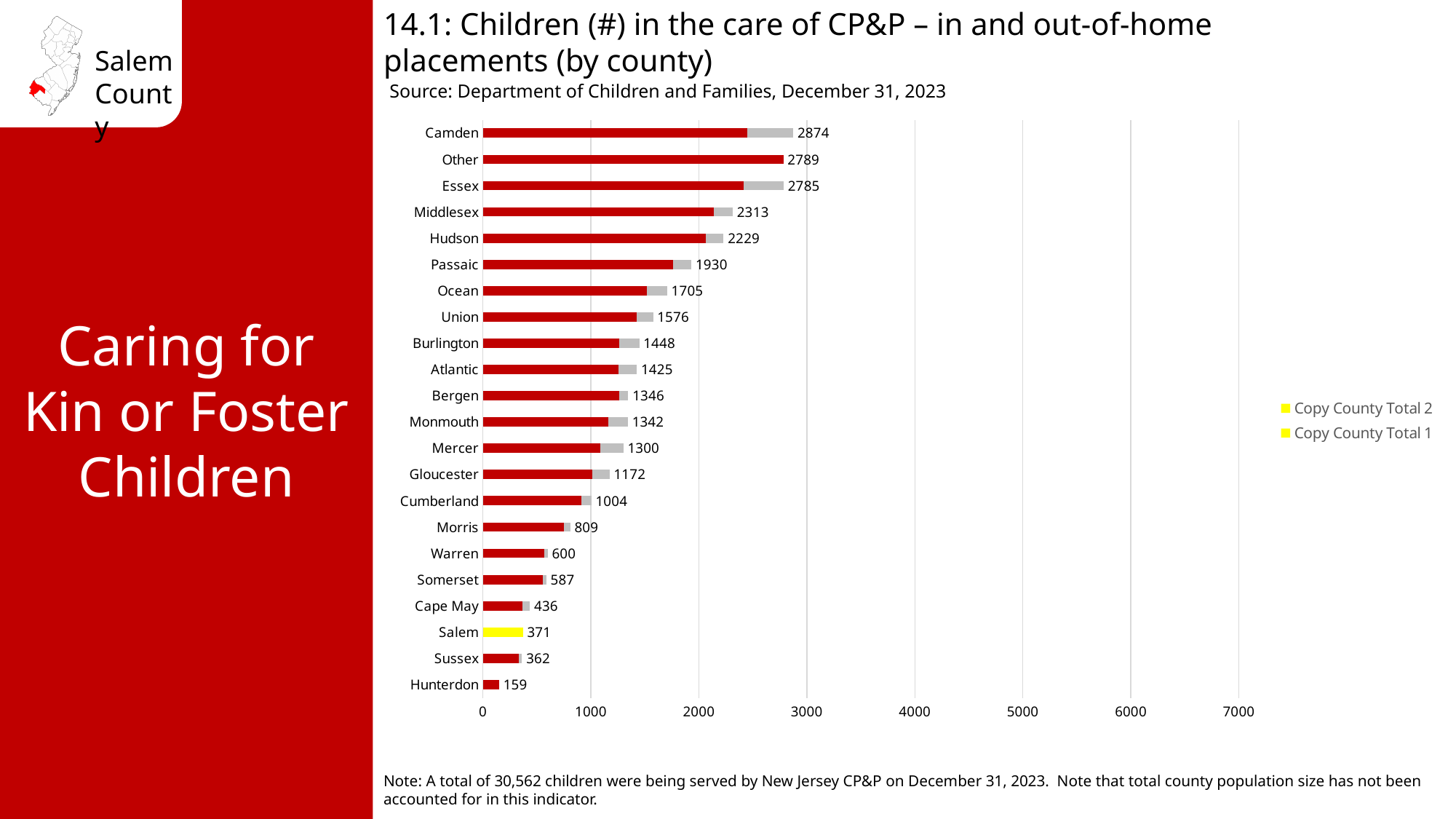
How many series does the legend list? 2 What is the difference between the labelled totals for Salem and Sussex? 9 Which has a larger labelled total, Passaic or Ocean? Passaic Is the total bar for Salem greater or less than 1000? less What value is labelled for Gloucester? 1172 What kind of chart is shown on the slide? Bar chart What value is labelled for Salem on the chart? 371 What is the total number of children in the care of CP&P shown for Camden? 2874 Which county has the lowest labelled total on the chart? Hunterdon Which county has the highest labelled total on the chart? Camden What is the difference between the labelled totals for Camden and Other? 85 How many counties (categories) are listed on the chart? 22